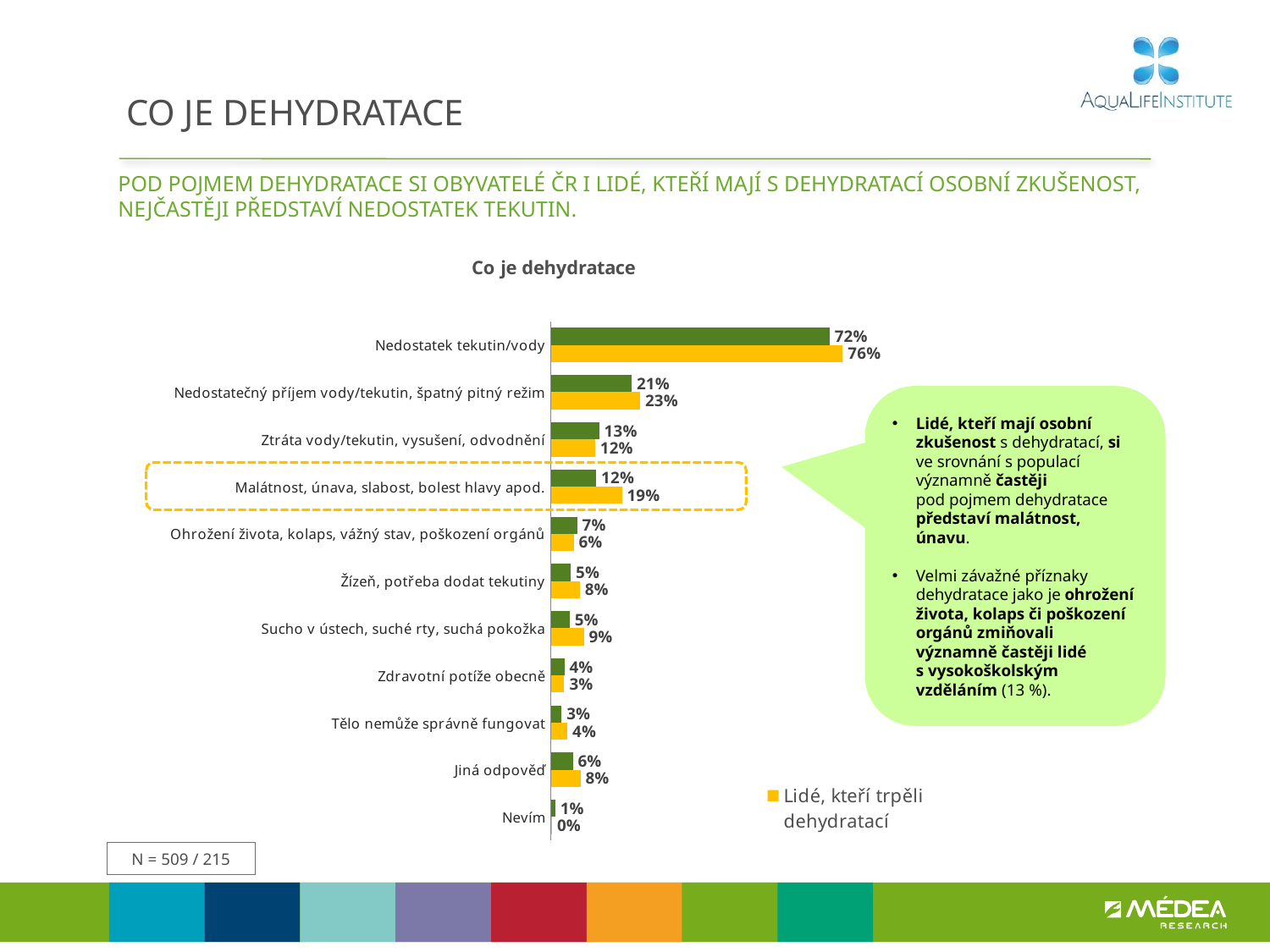
For "Sucho v ústech, suché rty, suchá pokožka", which is larger: the green bar or the yellow bar? The yellow bar What type of chart is shown under the title "Co je dehydratace"? Bar chart How many categories are listed on the vertical axis of the chart? 11 What is the value of the yellow bar (Lidé, kteří trpěli dehydratací) for "Nedostatek tekutin/vody"? 76% What is the value of the green bar for "Nedostatek tekutin/vody"? 72% What is the difference between the yellow and green bars for "Malátnost, únava, slabost, bolest hlavy apod."? 7% Which category has the highest value for the yellow series (Lidé, kteří trpěli dehydratací)? Nedostatek tekutin/vody What is the difference between the yellow and green bars for "Nedostatek tekutin/vody"? 4% What is the legend label shown for the yellow series? Lidé, kteří trpěli dehydratací What is the value of the yellow bar (Lidé, kteří trpěli dehydratací) for "Malátnost, únava, slabost, bolest hlavy apod."? 19% What is the value of the green bar for "Ztráta vody/tekutin, vysušení, odvodnění"? 13% Which category has the lowest value for the yellow series (Lidé, kteří trpěli dehydratací)? Nevím